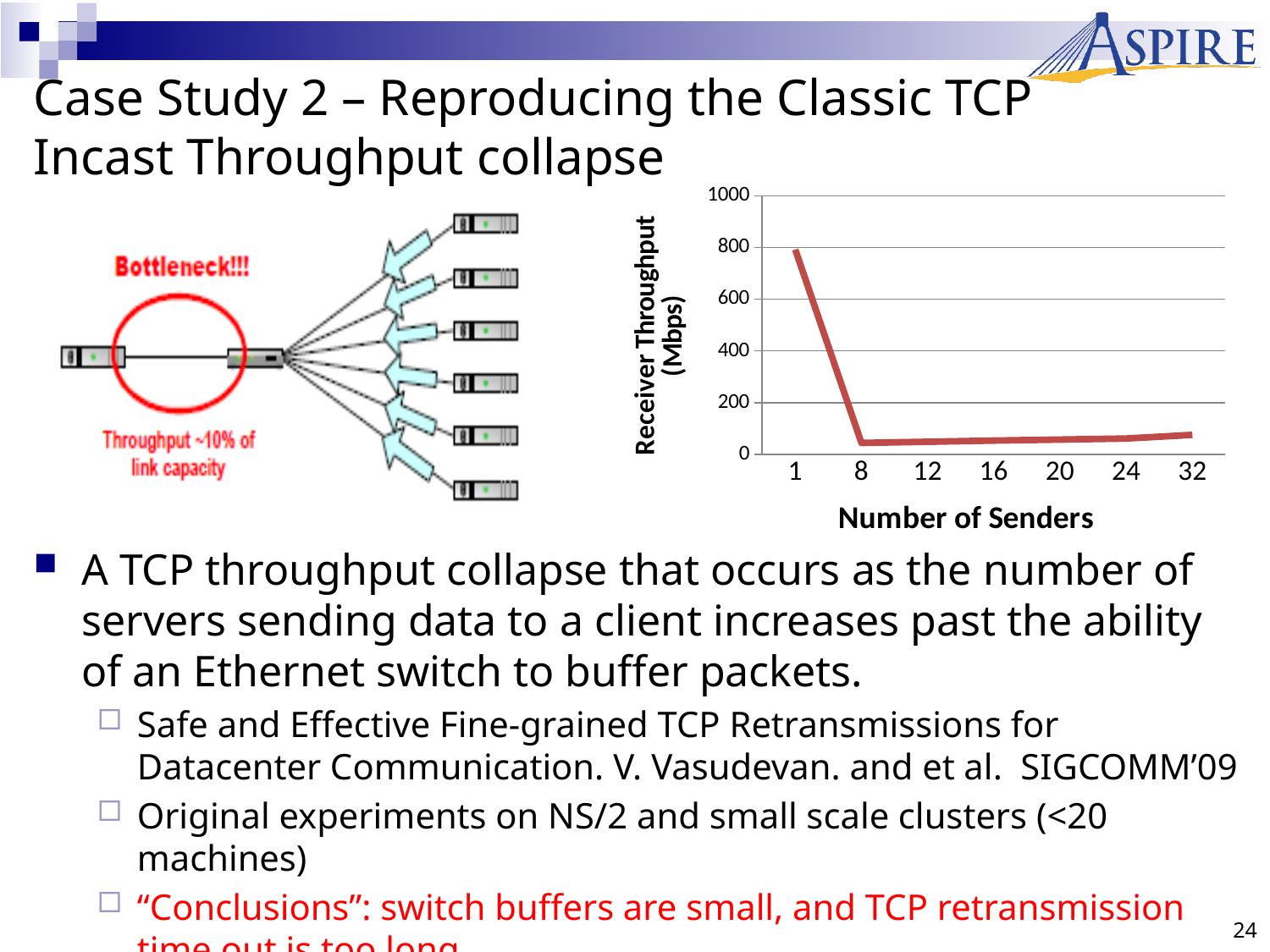
Is the receiver throughput for 8 senders greater or less than 200? less At which number of senders is the receiver throughput highest? 1 Is the receiver throughput for 1 sender greater or less than 600? greater What kind of chart is shown on the slide? line chart Is the receiver throughput for 32 senders greater or less than 200? less How many x-axis tick values (numbers of senders) are shown on the chart? 7 What is the label of the x-axis of the chart? Number of Senders What is the maximum value shown on the y-axis of the chart? 1000 What is the label of the y-axis of the chart? Receiver Throughput (Mbps) Which has a higher receiver throughput: 1 sender or 32 senders? 1 sender Does the receiver throughput rise or fall as the number of senders increases from 1 to 8? fall